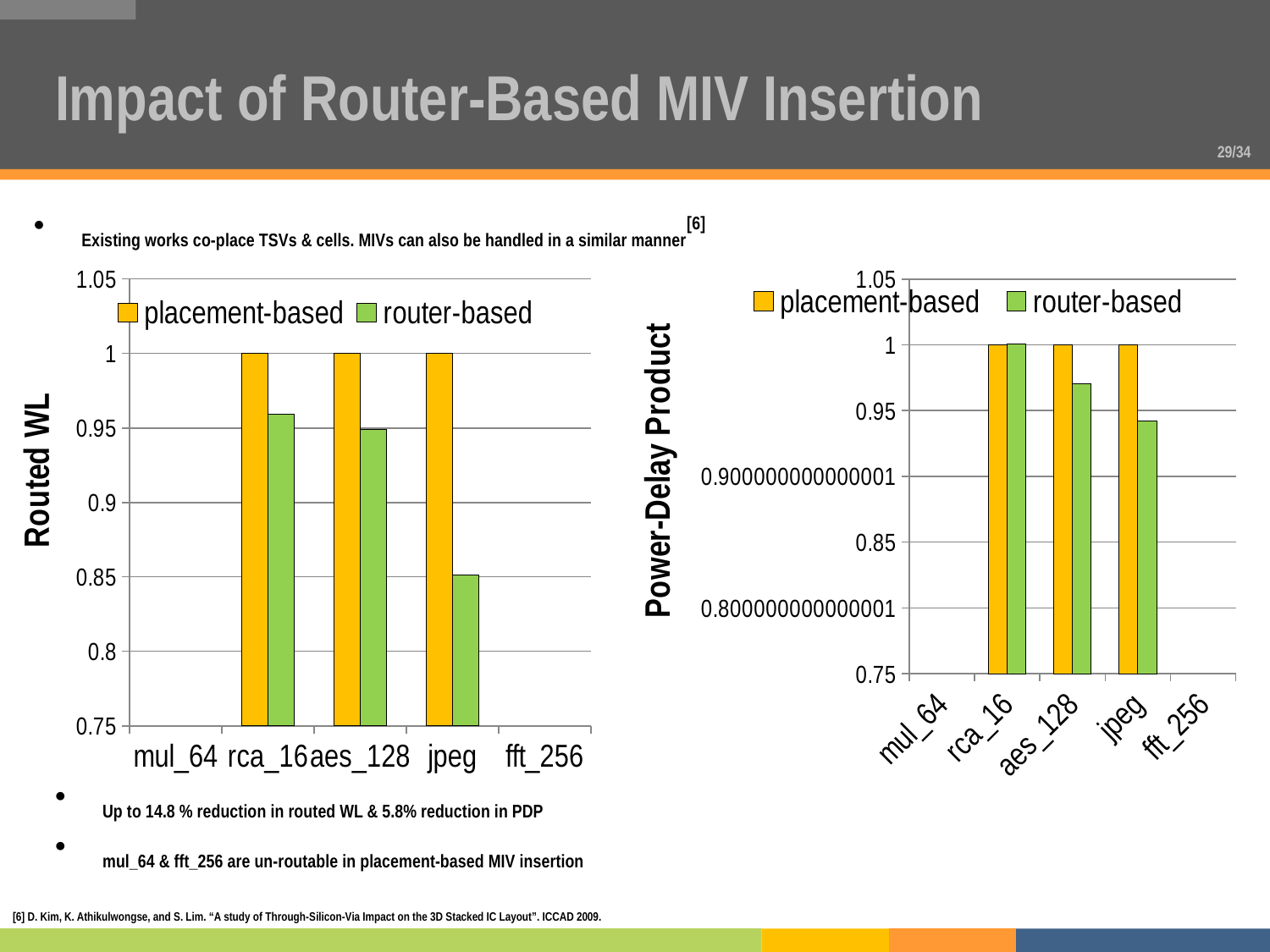
In the Routed WL chart, what is the placement-based value for jpeg? 1 In the Routed WL chart, is the router-based value for rca_16 greater or less than 0.95? greater What is the y-axis label of the chart on the right? Power-Delay Product In the Power-Delay Product chart, what is the placement-based value for aes_128? 1 How many series does the legend of the Power-Delay Product chart list? 2 Which series is shown in green in the Routed WL chart? router-based In the Routed WL chart, which category has the lowest router-based value? jpeg In the Power-Delay Product chart, is the router-based value for jpeg greater or less than 0.95? less How many categories are shown on the x axis of the Routed WL chart? 5 In the Routed WL chart, is the router-based value for jpeg greater or less than 0.9? less In the Power-Delay Product chart, which is larger for aes_128: the placement-based value or the router-based value? placement-based What kind of chart is the Routed WL chart on the left? bar chart